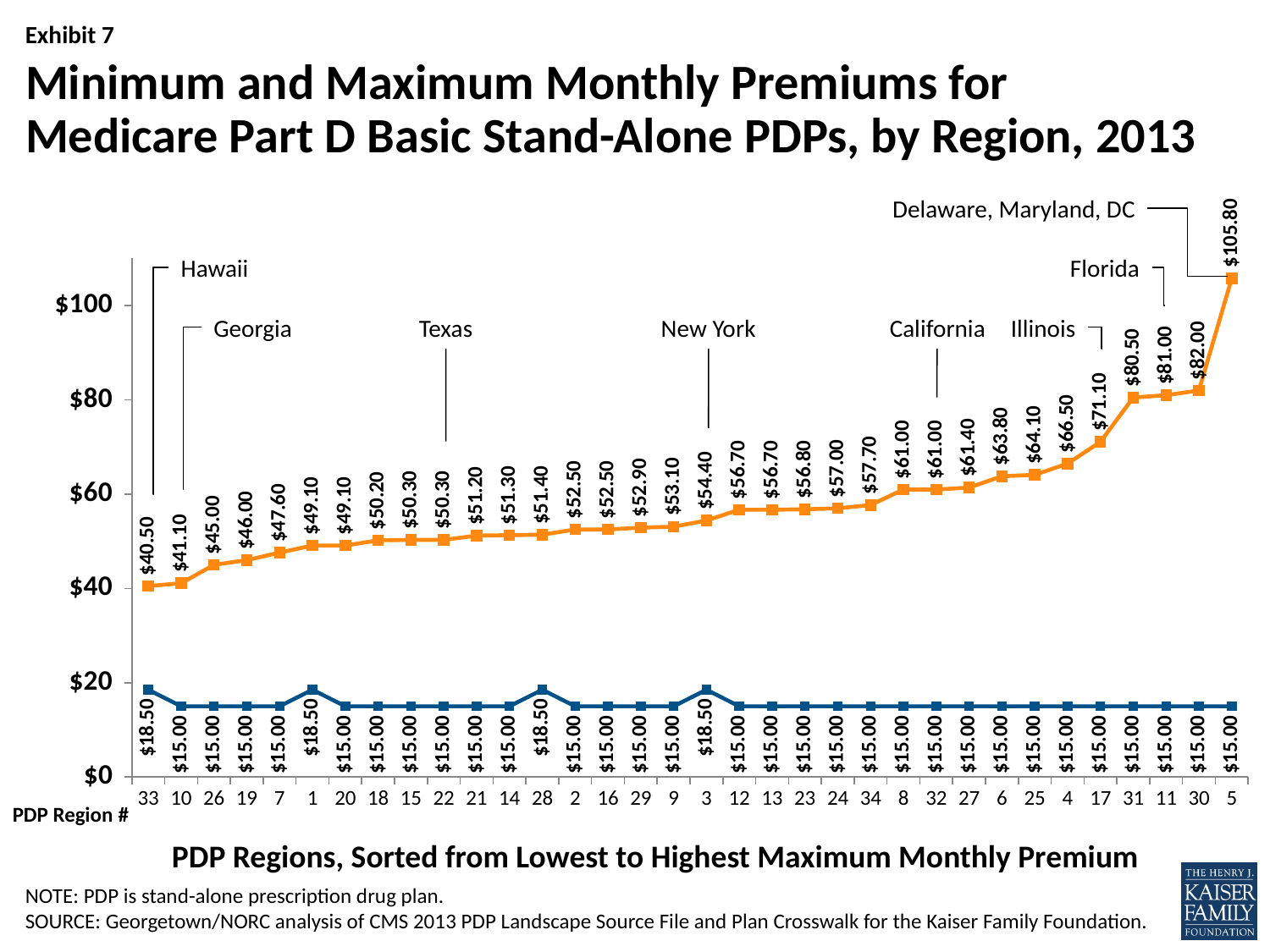
Which PDP region has the lowest maximum monthly premium? Region 33 What is the maximum monthly premium for PDP region 5? $105.80 Which PDP region has the highest maximum monthly premium? Region 5 What is the difference between the maximum and minimum monthly premiums for region 33? $22.00 What kind of chart is shown on the slide? Line chart Does the maximum monthly premium line rise or fall from left to right along the x axis? Rise How many PDP regions are plotted on the x axis? 34 What is the minimum monthly premium for PDP region 28? $18.50 What is the difference between the maximum monthly premiums of region 5 and region 30? $23.80 Which has a higher maximum monthly premium, region 17 or region 4? Region 17 What is the maximum monthly premium for PDP region 22 (Texas)? $50.30 What is the minimum monthly premium for PDP region 33? $18.50